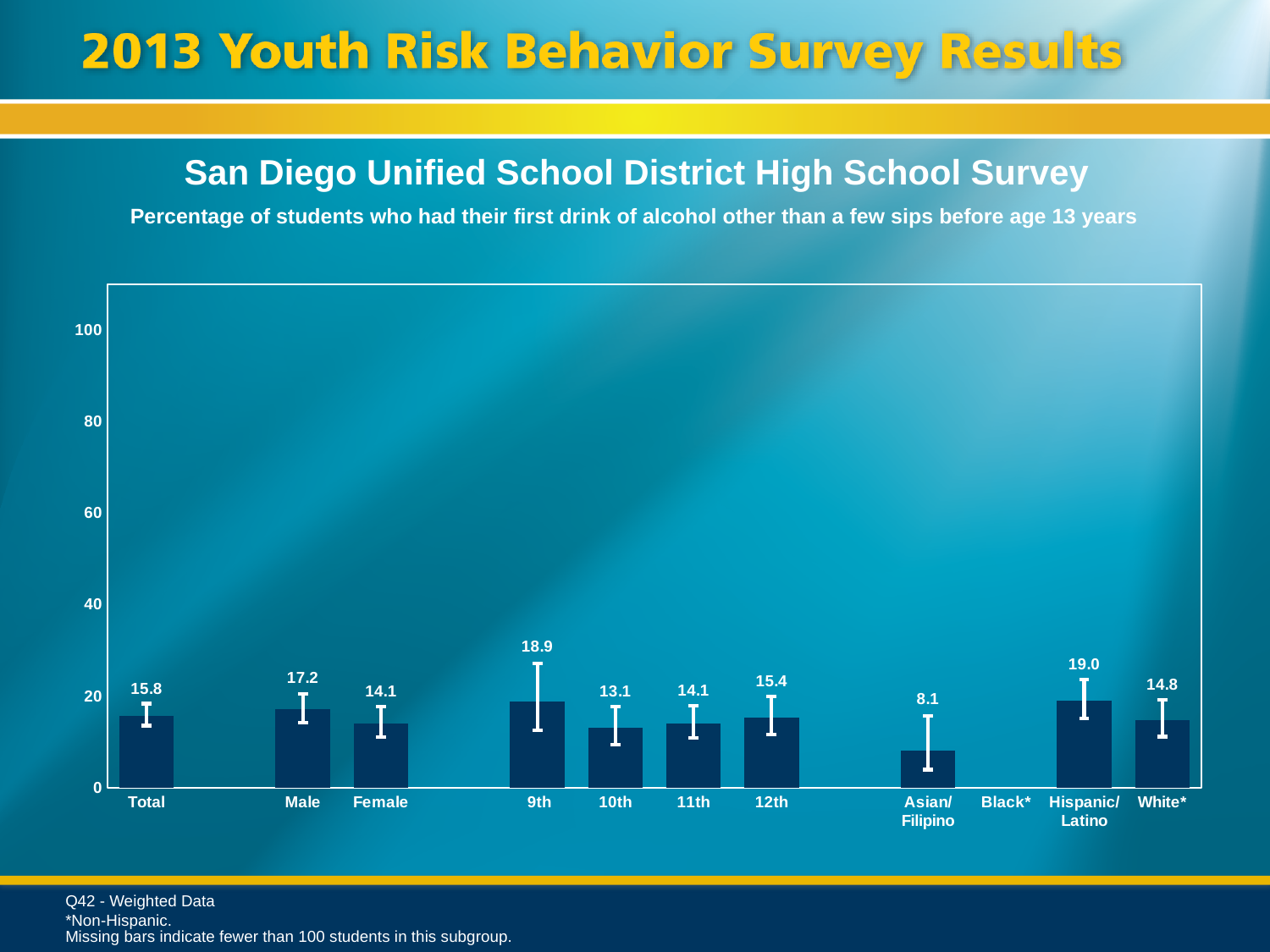
What is the value for Total? 15.8 Which category label has no bar plotted? Black* What is the difference between the values for Male and Female? 3.1 Is the value for White* greater or less than 20? less What is the difference between the values for 9th grade and 10th grade? 5.8 What is the value for Hispanic/Latino? 19.0 What type of chart is shown? bar chart What is the value for 9th grade? 18.9 Which is larger, the value for 12th grade or the value for 10th grade? 12th Which category has the lowest value? Asian/Filipino Among the grade levels (9th, 10th, 11th, 12th), which has the highest value? 9th What is the value for Asian/Filipino? 8.1